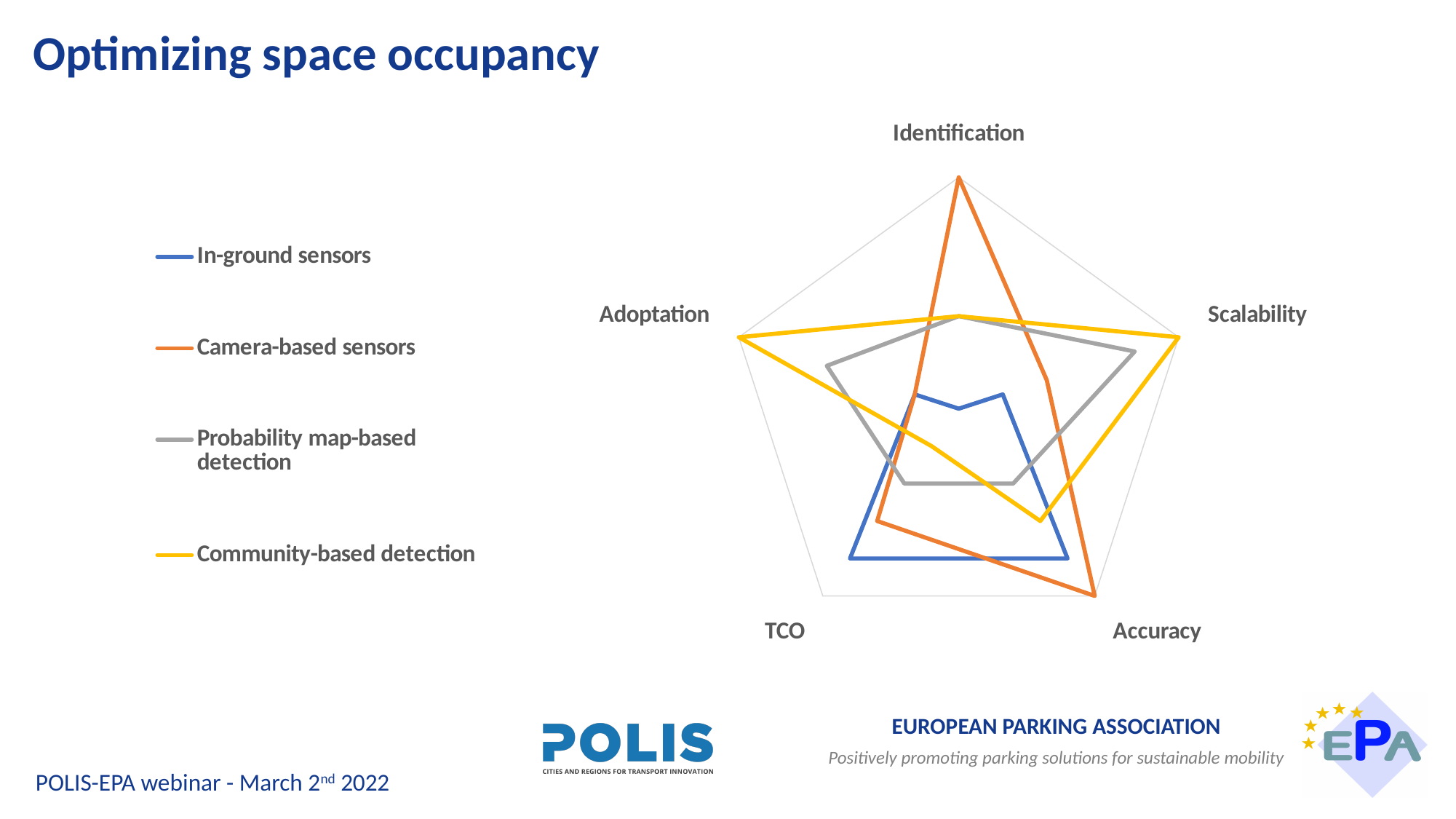
How many axes (criteria) does the radar chart have? 5 Which series scores highest on the TCO axis? In-ground sensors On the TCO axis, which scores higher: In-ground sensors or Camera-based sensors? In-ground sensors Which series scores highest on the Scalability axis? Community-based detection On the Identification axis, which scores higher: Camera-based sensors or Community-based detection? Camera-based sensors Which series scores highest on the Accuracy axis? Camera-based sensors How many series does the legend list? 4 What colour is the line for Community-based detection? Yellow Which series scores lowest on the Scalability axis? In-ground sensors What kind of chart is shown on the slide? Radar chart